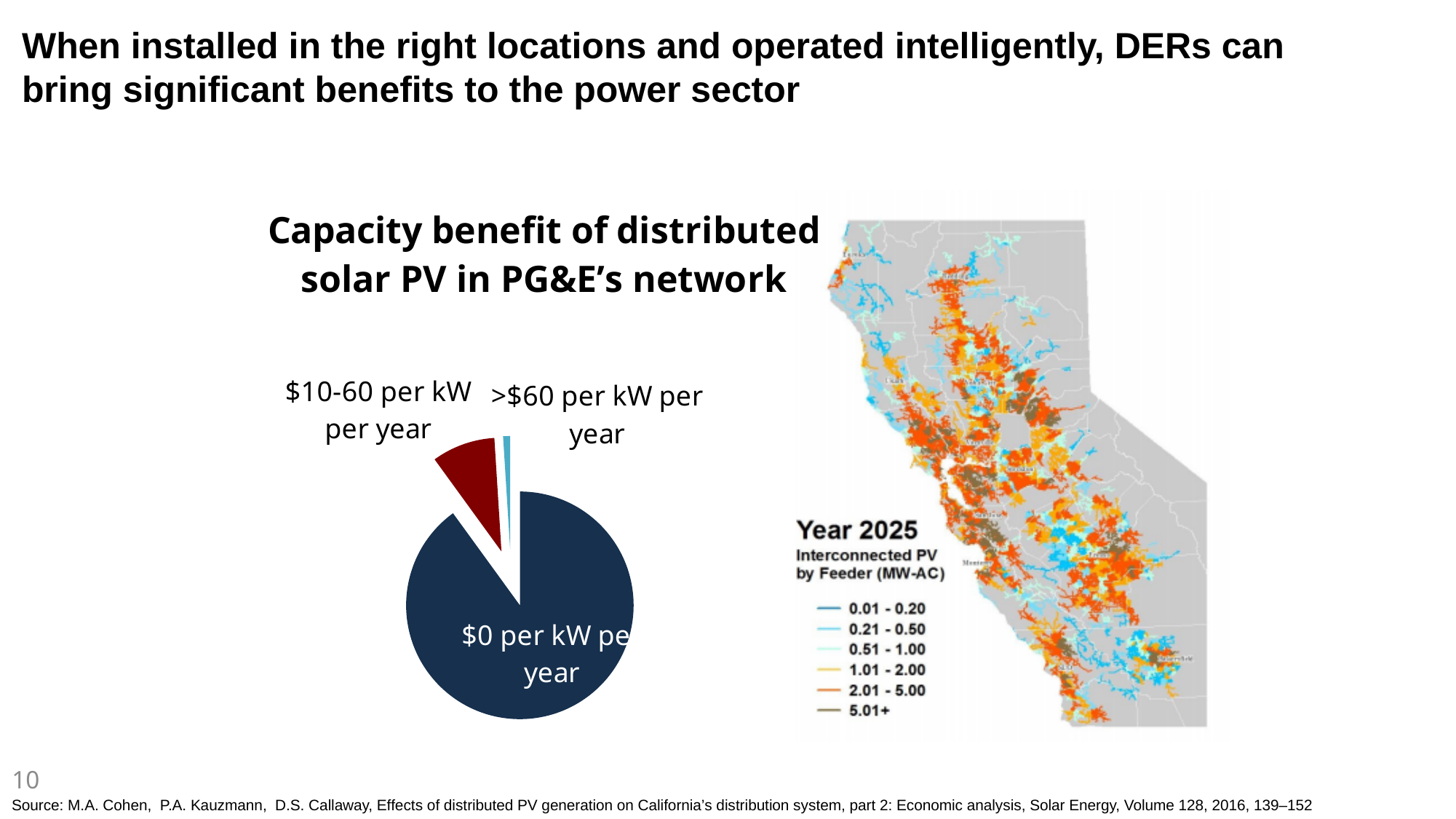
What kind of chart is used to show the capacity benefit of distributed solar PV in PG&E's network? pie chart How many slices does the pie chart on the capacity benefit of distributed solar PV have? 3 Which category takes up the smallest share of the pie chart on the capacity benefit of distributed solar PV? >$60 per kW per year Which category takes up the largest share of the pie chart on the capacity benefit of distributed solar PV? $0 per kW per year What is the title of the pie chart on the slide? Capacity benefit of distributed solar PV in PG&E's network In the pie chart, which slice is larger: "$10-60 per kW per year" or ">$60 per kW per year"? $10-60 per kW per year In the pie chart, which slice is larger: "$0 per kW per year" or "$10-60 per kW per year"? $0 per kW per year What colour is the "$10-60 per kW per year" slice in the pie chart? dark red